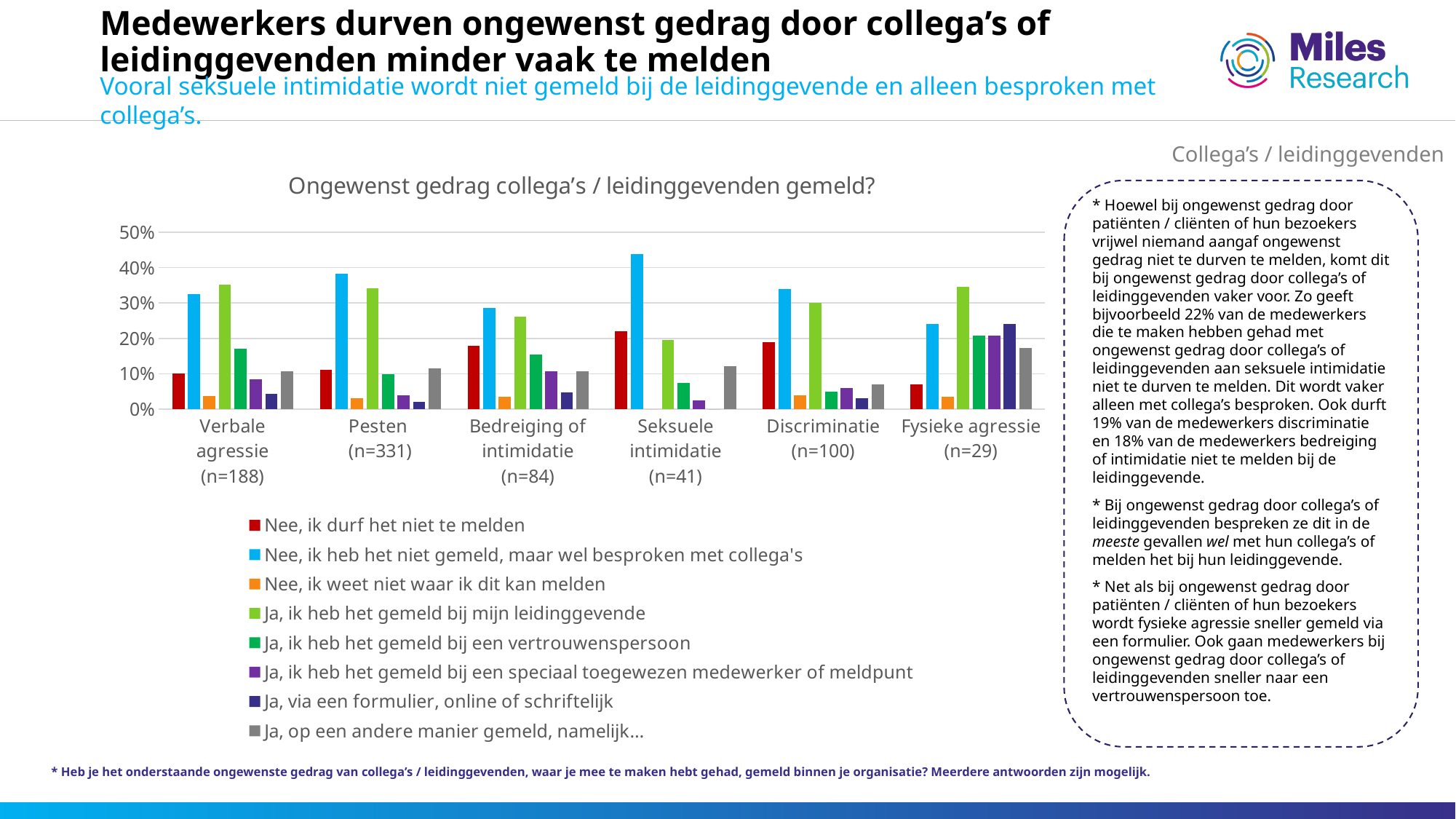
Is the value for 'Nee, ik heb het niet gemeld, maar wel besproken met collega's' in the Seksuele intimidatie category greater or less than 40%? greater Is the value for 'Ja, via een formulier, online of schriftelijk' in the Fysieke agressie category greater or less than 20%? greater In which category is the bar for 'Nee, ik weet niet waar ik dit kan melden' the lowest? Seksuele intimidatie How many categories of unwanted behaviour are shown on the x axis of the chart? 6 How many series does the chart's legend list? 8 What kind of chart is shown on the slide? bar chart In which category is the bar for 'Nee, ik heb het niet gemeld, maar wel besproken met collega's' the highest? Seksuele intimidatie In the Pesten category, which is larger: 'Nee, ik heb het niet gemeld, maar wel besproken met collega's' or 'Ja, ik heb het gemeld bij mijn leidinggevende'? Nee, ik heb het niet gemeld, maar wel besproken met collega's Is the value for 'Nee, ik durf het niet te melden' in the Bedreiging of intimidatie category greater or less than 20%? less What is the title of the chart? Ongewenst gedrag collega’s / leidinggevenden gemeld? In the Fysieke agressie category, which is larger: 'Ja, ik heb het gemeld bij mijn leidinggevende' or 'Nee, ik heb het niet gemeld, maar wel besproken met collega's'? Ja, ik heb het gemeld bij mijn leidinggevende